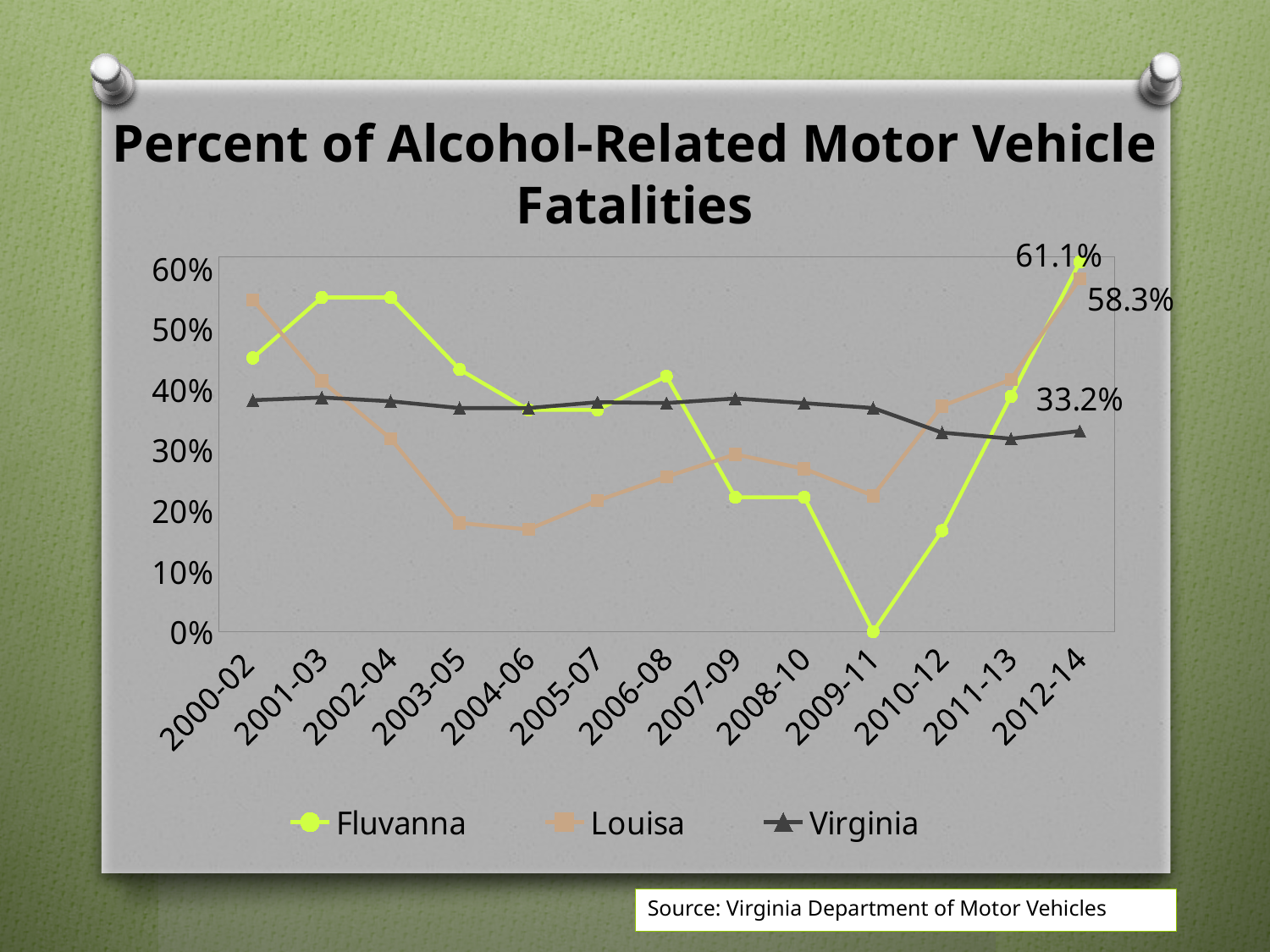
Does the Fluvanna line rise or fall from 2009-11 to 2012-14? rise What is the value for Fluvanna in 2009-11? 0% What is the value for Fluvanna in 2012-14? 61.1% How many time periods are shown on the x axis? 13 Is the value for Louisa in 2003-05 greater or less than 20%? less What type of chart is shown on the slide? line chart How many series does the legend list? 3 Which series has the highest value in 2012-14? Fluvanna Which series has the lowest value in 2012-14? Virginia What is the value for Virginia in 2012-14? 33.2% What is the difference between the Fluvanna and Virginia values in 2012-14? 27.9% What is the value for Louisa in 2012-14? 58.3%